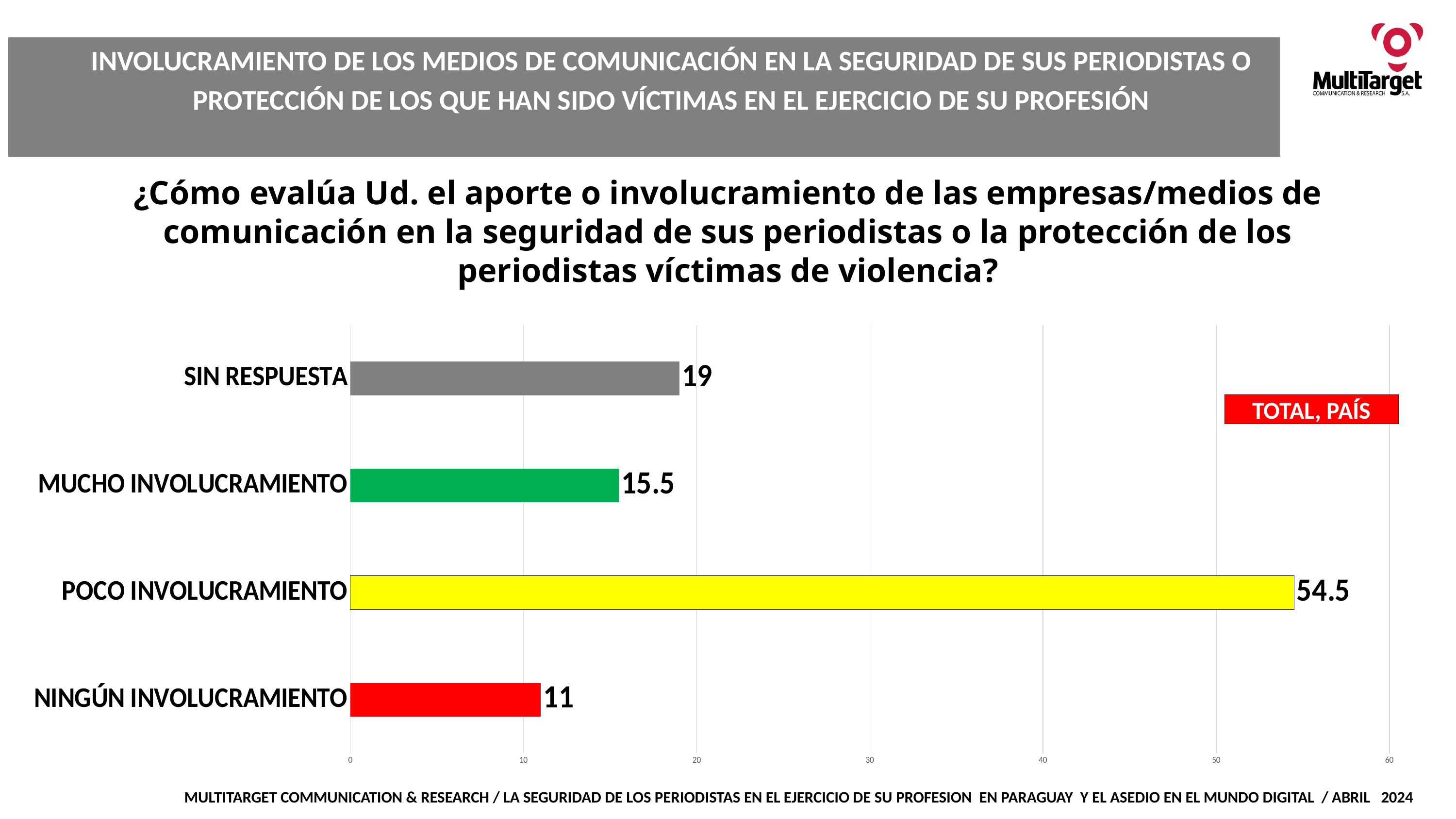
Is the value for POCO INVOLUCRAMIENTO greater or less than 50? greater Which is larger, the value for SIN RESPUESTA or the value for MUCHO INVOLUCRAMIENTO? SIN RESPUESTA How many categories are shown in the chart? 4 Which category has the highest value? POCO INVOLUCRAMIENTO What is the value for SIN RESPUESTA? 19 What kind of chart is shown on the slide? bar chart Which category has the lowest value? NINGÚN INVOLUCRAMIENTO What is the value for NINGÚN INVOLUCRAMIENTO? 11 What is the value for MUCHO INVOLUCRAMIENTO? 15.5 What is the difference between the values for SIN RESPUESTA and NINGÚN INVOLUCRAMIENTO? 8 What is the value for POCO INVOLUCRAMIENTO? 54.5 What is the difference between the values for POCO INVOLUCRAMIENTO and MUCHO INVOLUCRAMIENTO? 39